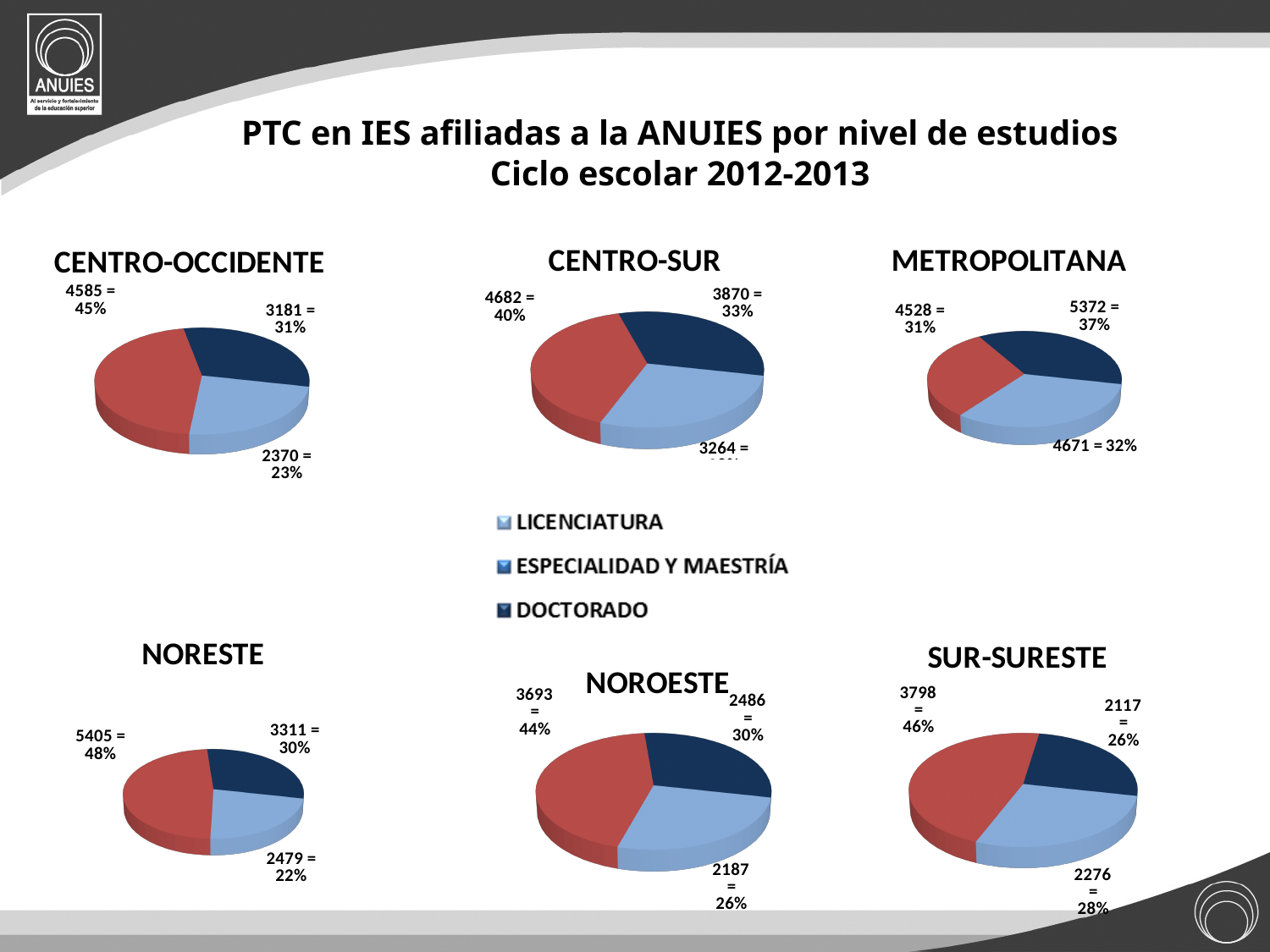
How many entries does the shared legend list? 3 What is the first entry listed in the legend? LICENCIATURA How many slices does the CENTRO-OCCIDENTE pie chart have? 3 In the SUR-SURESTE pie chart, what is the total of the three slice values? 8191 In the CENTRO-SUR pie chart, which is larger: the slice labelled 4682 or the slice labelled 3870? 4682 In the NOROESTE pie chart, what is the value of the smallest slice? 2187 = 26% What kind of charts are shown on the slide? Pie charts In the NORESTE pie chart, what percentage share does the largest slice have? 48% In the NORESTE pie chart, what is the difference between the 5405 slice and the 3311 slice? 2094 In the CENTRO-OCCIDENTE pie chart, what is the total of the three slice values? 10136 In the METROPOLITANA pie chart, what is the value of the largest slice? 5372 = 37% In the CENTRO-OCCIDENTE pie chart, what is the value of the largest slice? 4585 = 45%